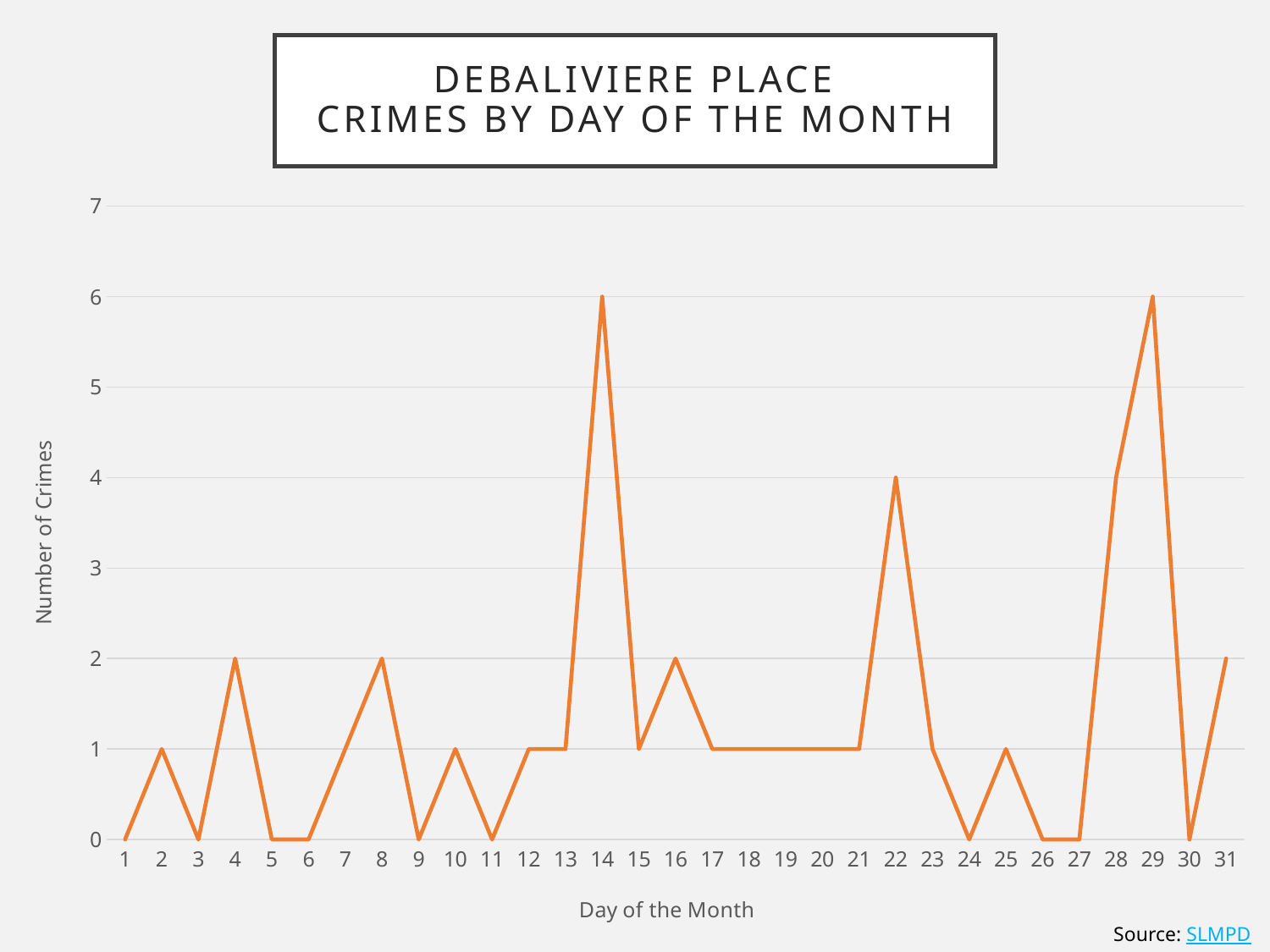
Is the value for day 29 greater or less than 5? greater What is the label of the vertical axis? Number of Crimes How many crimes were recorded on day 1 of the month? 0 What is the difference between the number of crimes on day 14 and on day 22? 2 How many crimes were recorded on day 14 of the month? 6 How many crimes were recorded on day 22 of the month? 4 How many crimes were recorded on day 28 of the month? 4 How many crimes were recorded on day 31 of the month? 2 Which day had more crimes, day 16 or day 22? day 22 What kind of chart is shown on the slide? line chart What is the highest number of crimes recorded on any single day? 6 How many days of the month are plotted on the x axis? 31